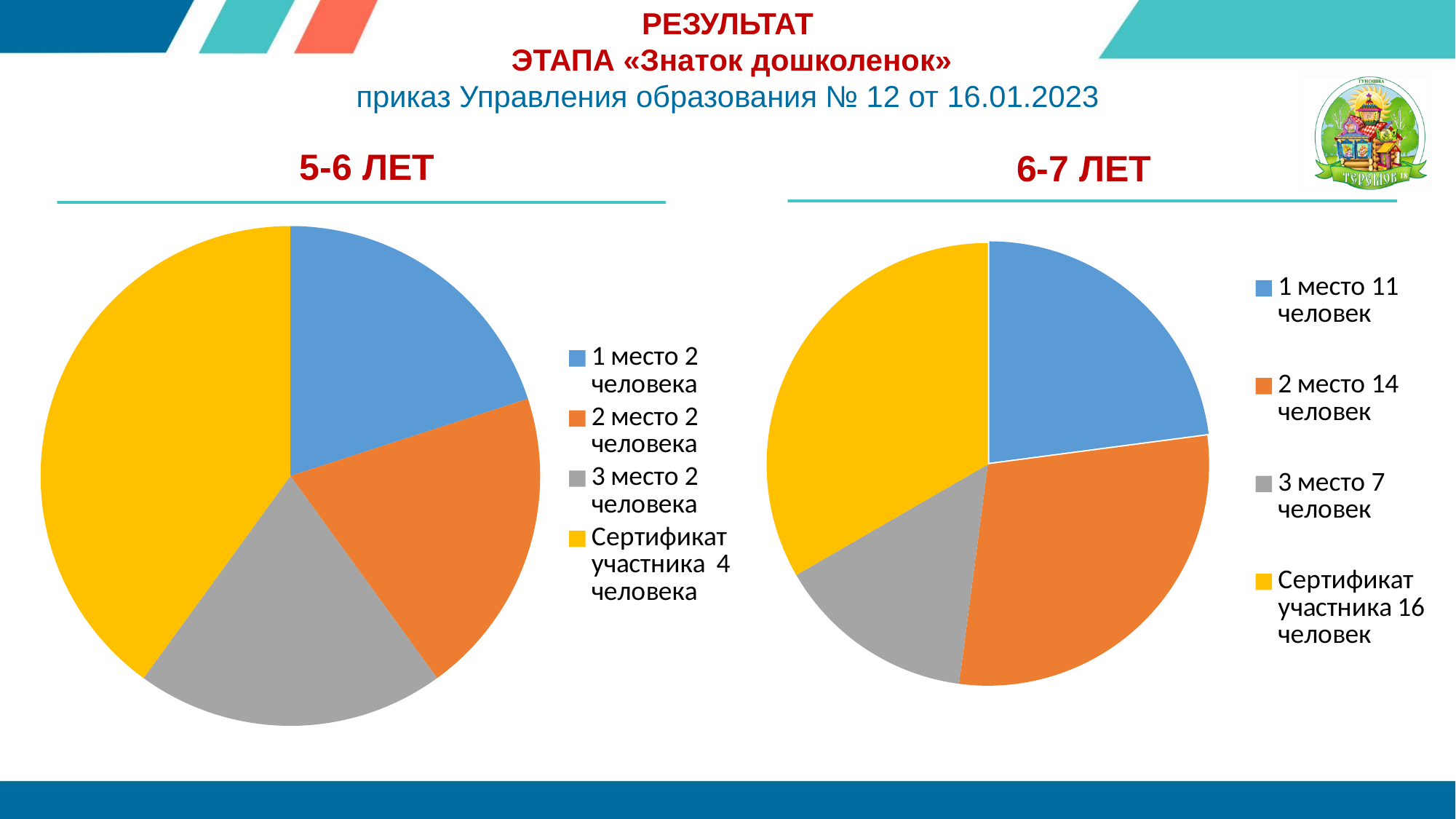
In the "6-7 ЛЕТ" chart, how many people took 2 место? 14 человек In the "5-6 ЛЕТ" chart, which category has the largest slice? Сертификат участника In the "5-6 ЛЕТ" chart, how many people received a certificate of participation (Сертификат участника)? 4 человека In the "6-7 ЛЕТ" chart, which category has the smallest slice? 3 место In the "5-6 ЛЕТ" chart, what share of the pie does Сертификат участника represent? 40% In the "5-6 ЛЕТ" chart, how many people took 1 место? 2 человека What kind of chart is shown under the heading "5-6 ЛЕТ"? Pie chart In the "6-7 ЛЕТ" chart, which is larger: 1 место or 2 место? 2 место In the "6-7 ЛЕТ" chart, how many people received a certificate of participation (Сертификат участника)? 16 человек In the "6-7 ЛЕТ" chart, how many more people took 2 место than 3 место? 7 In the "6-7 ЛЕТ" chart, which category has the largest slice? Сертификат участника How many slices does the "5-6 ЛЕТ" pie chart have? 4